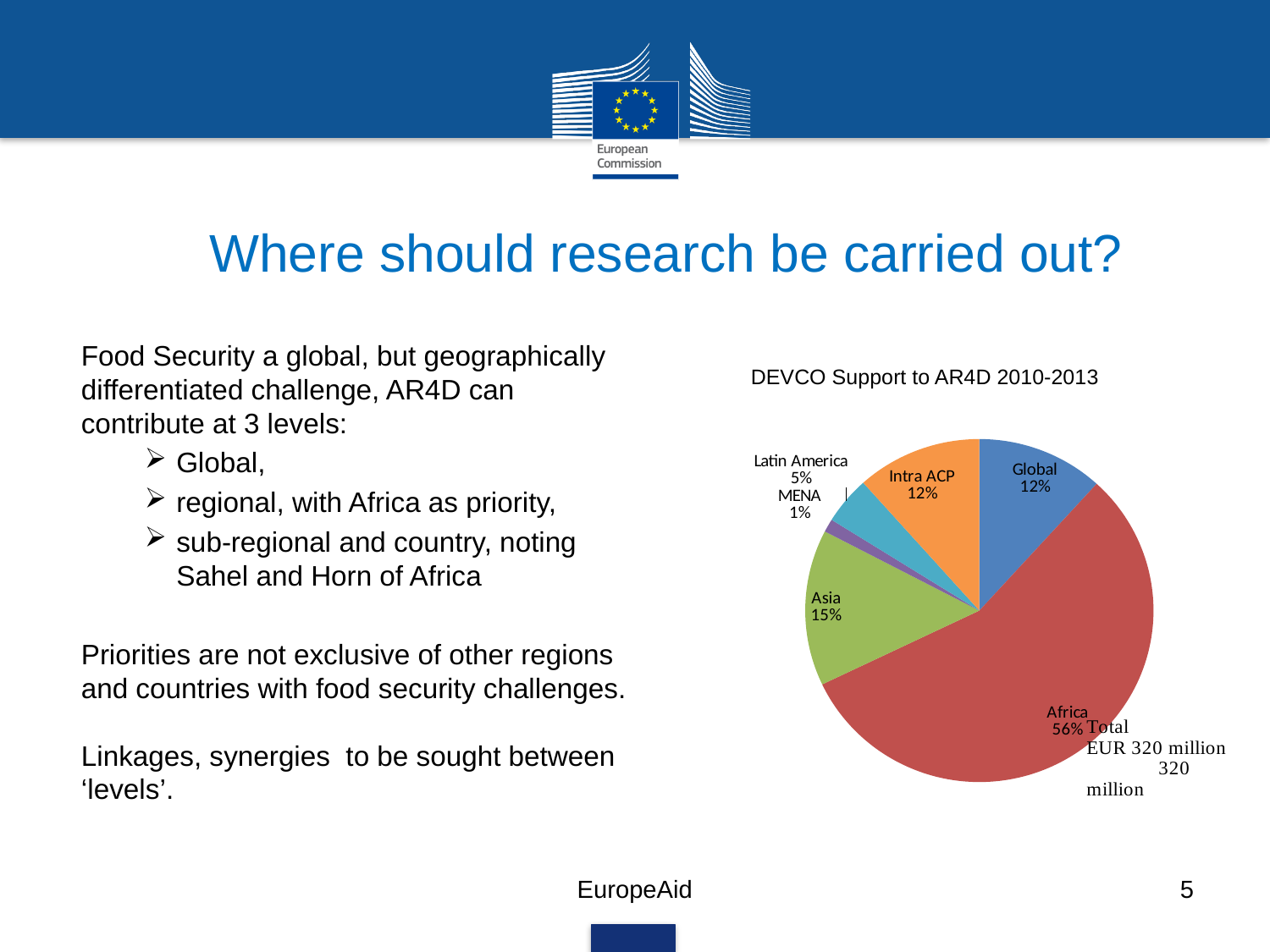
What share of the pie does MENA represent? 1% What type of chart is shown on the slide? pie chart What share of the pie does Global represent? 12% Which region has the smallest share of the pie? MENA Which has a larger share, Asia or Intra ACP? Asia How many slices does the pie chart have? 6 What share of the pie does Africa represent? 56% What is the title of the chart? DEVCO Support to AR4D 2010-2013 What is the difference in percentage points between the Africa and Asia shares? 41 Which region has the largest share of the pie? Africa